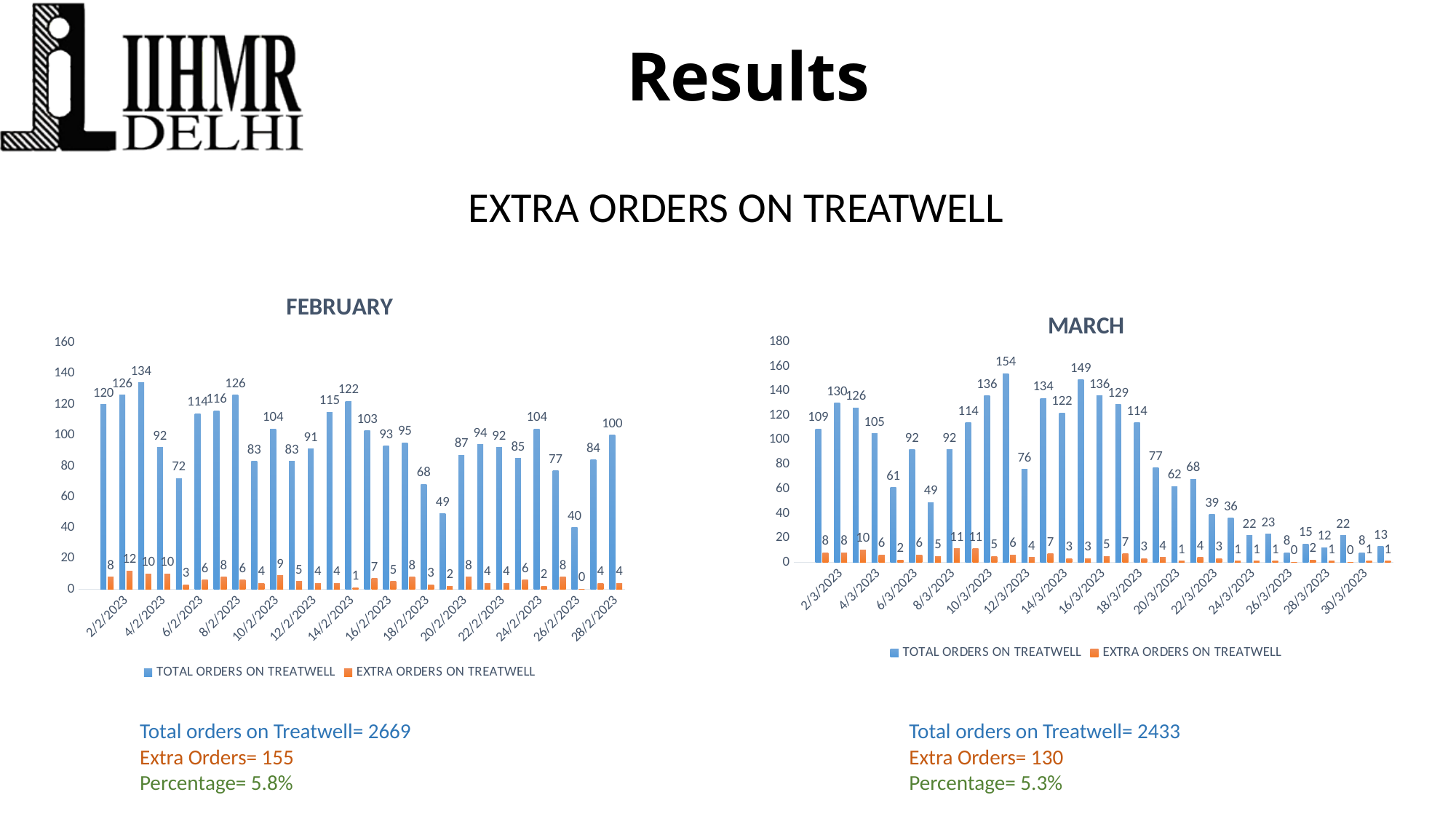
In the FEBRUARY chart, what is the highest value for TOTAL ORDERS ON TREATWELL? 134 In the MARCH chart, what is the highest value for EXTRA ORDERS ON TREATWELL? 11 What kind of chart is the FEBRUARY chart? bar chart What are the two legend entries shown under the FEBRUARY chart? TOTAL ORDERS ON TREATWELL and EXTRA ORDERS ON TREATWELL What is the difference between the highest TOTAL ORDERS ON TREATWELL value in the MARCH chart and the highest in the FEBRUARY chart? 20 In the MARCH chart, do the TOTAL ORDERS ON TREATWELL values generally rise or fall over the second half of the month? fall In the MARCH chart, what is the highest value for TOTAL ORDERS ON TREATWELL? 154 In the FEBRUARY chart, what is the lowest value for TOTAL ORDERS ON TREATWELL? 40 How many series does the legend of the MARCH chart list? 2 How many days (pairs of bars) are plotted in the MARCH chart? 31 Which chart has the higher peak value for TOTAL ORDERS ON TREATWELL, FEBRUARY or MARCH? MARCH